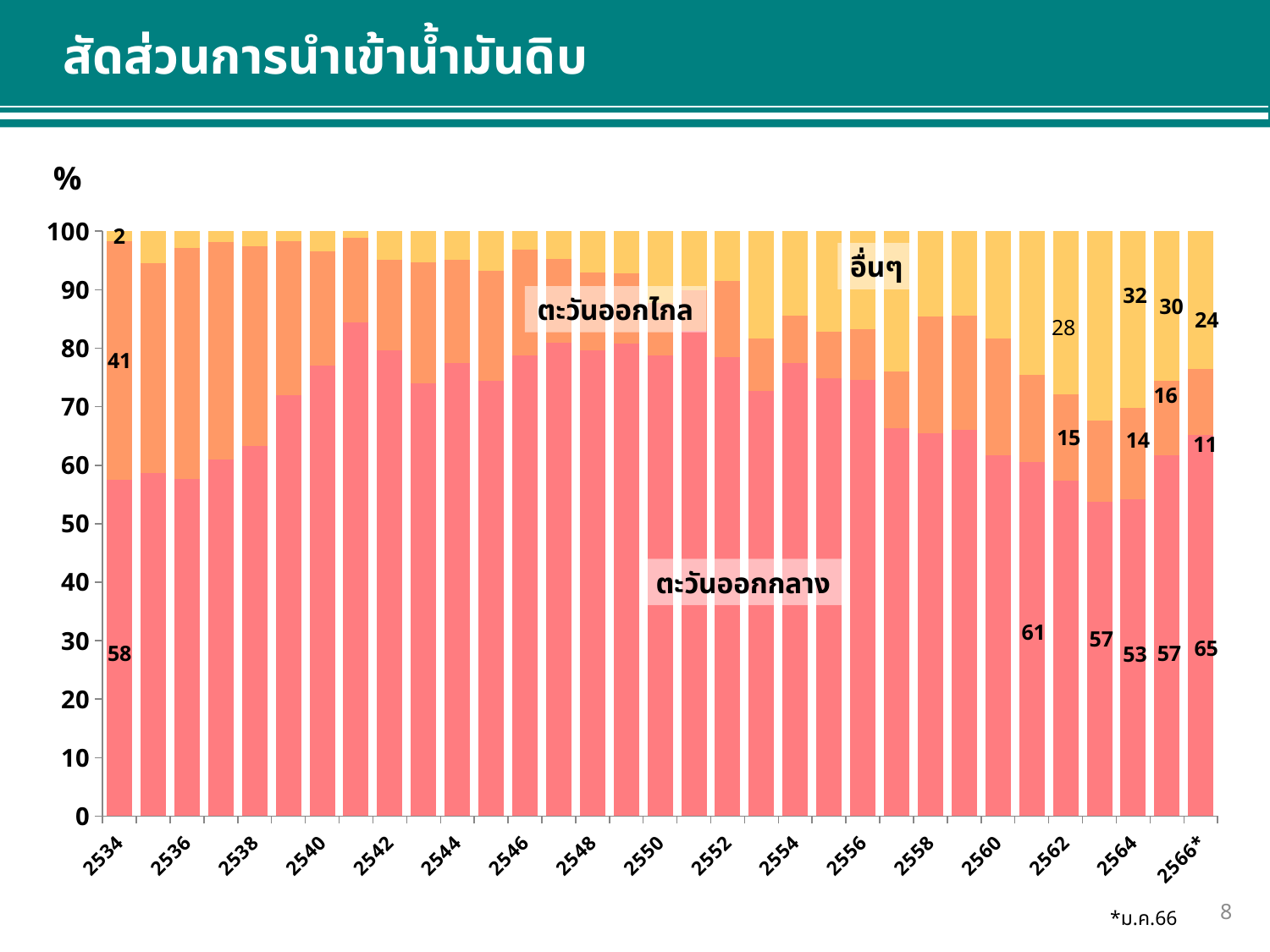
Is the share of ตะวันออกกลาง in 2541 greater or less than 80? greater What is the share of อื่นๆ in 2534? 2 What is the share of ตะวันออกกลาง in 2534? 58 How many years (bars) are plotted in the chart? 33 What is the title of the chart? สัดส่วนการนำเข้าน้ำมันดิบ What is the difference between the ตะวันออกกลาง share and the ตะวันออกไกล share in 2534? 17 How many regions (series) are labelled in the chart? 3 In 2534, which is larger: the share of ตะวันออกกลาง or the share of ตะวันออกไกล? ตะวันออกกลาง What is the share of ตะวันออกไกล in 2534? 41 What kind of chart is shown on the slide? stacked bar chart What is the share of อื่นๆ in 2566*? 24 Does the share of อื่นๆ generally rise or fall from 2534 to 2566*? rise